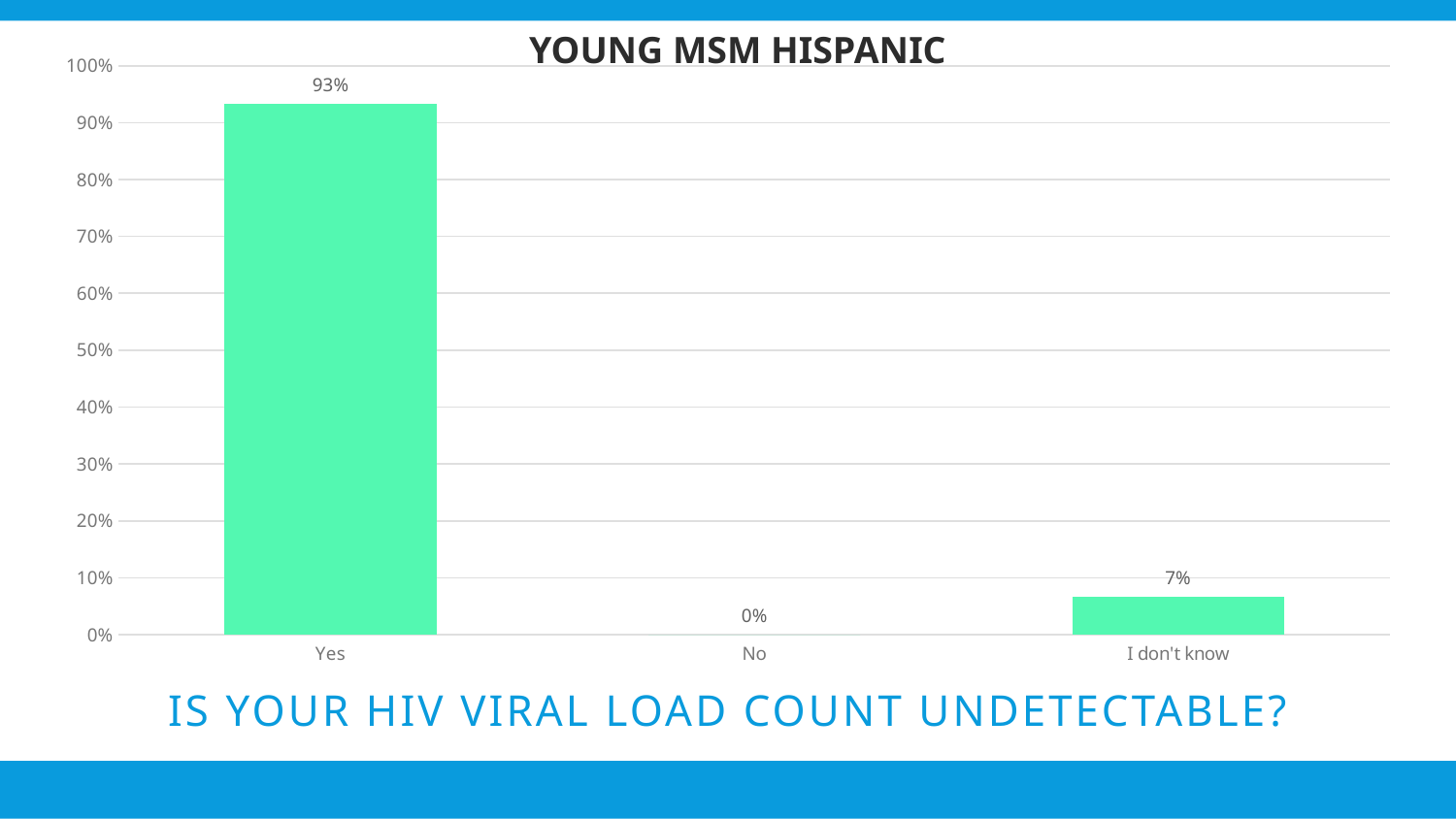
Which is larger, the value for "I don't know" or the value for "No"? I don't know What is the value for "I don't know"? 7% Is the value for "I don't know" greater or less than 10%? less What is the difference between the values for "Yes" and "I don't know"? 86% What is the value for "No"? 0% What is the value for "Yes"? 93% What kind of chart is shown on the slide? bar chart What is the title of the chart? YOUNG MSM HISPANIC How many categories are shown on the x axis? 3 Is the value for "Yes" greater or less than 90%? greater Which category has the highest value? Yes Which category has the lowest value? No